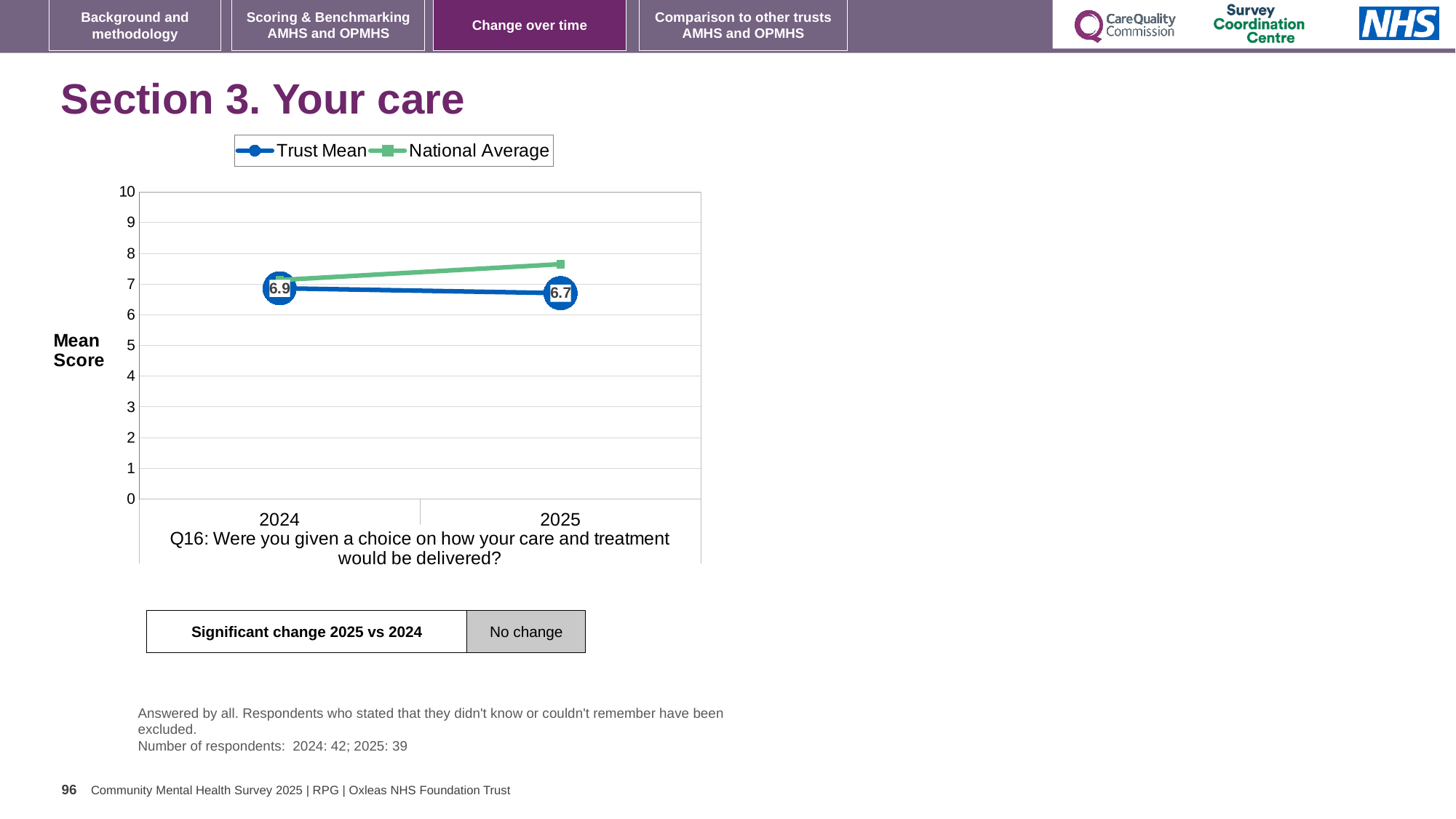
Does the Trust Mean rise or fall from 2024 to 2025? fall Which series has the higher value in 2025, Trust Mean or National Average? National Average Is the National Average for 2025 greater or less than 7? greater In which year is the Trust Mean highest? 2024 How many years are plotted on the x axis? 2 What is the Trust Mean score for 2025? 6.7 What is the Trust Mean score for 2024? 6.9 Does the National Average rise or fall from 2024 to 2025? rise How many series does the legend list? 2 What is the difference between the Trust Mean in 2024 and in 2025? 0.2 What kind of chart is shown on the slide? line chart What is the label on the y axis of the chart? Mean Score